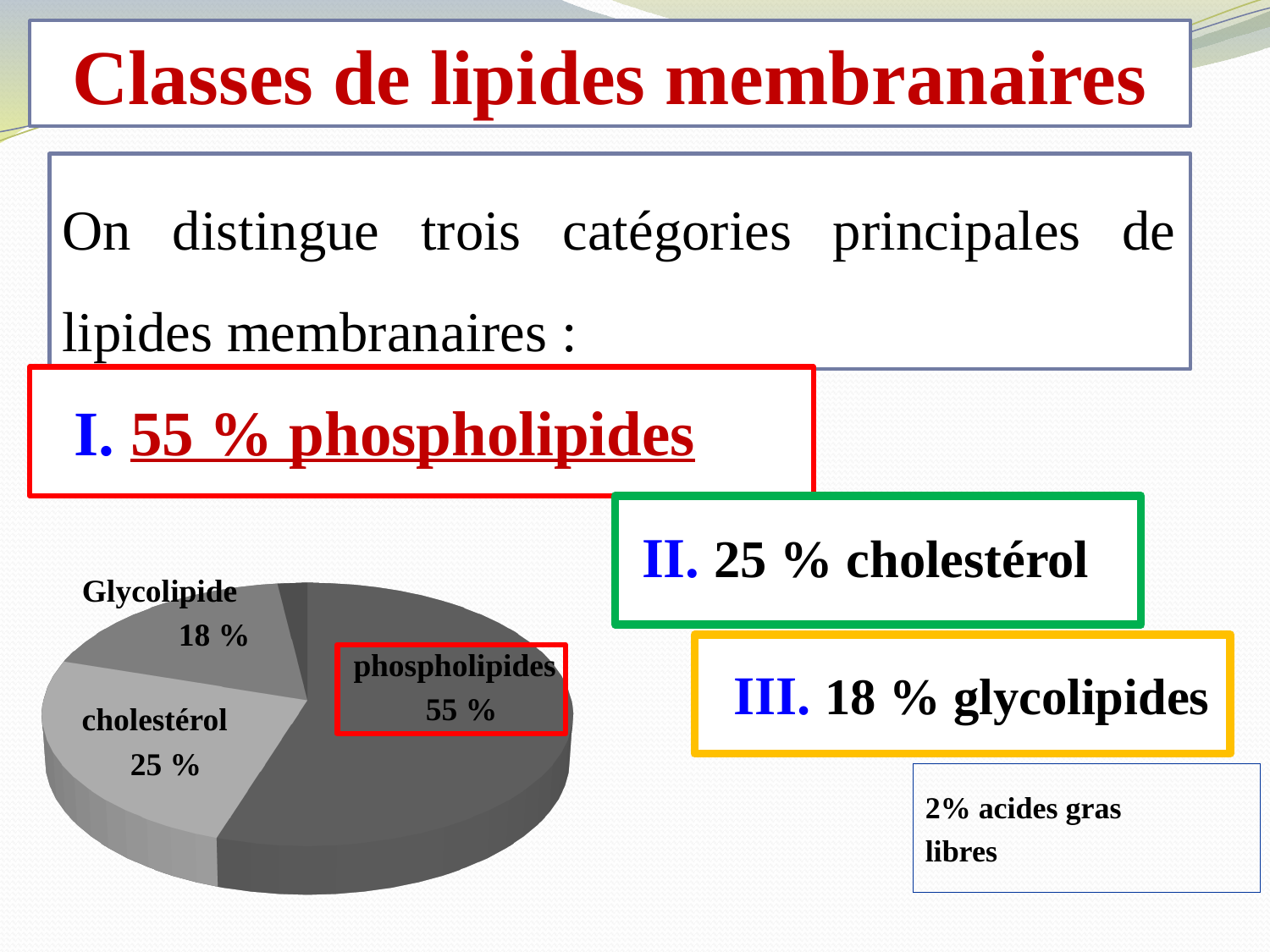
What percentage of the pie chart is Glycolipide? 18 % What kind of chart is shown on the slide? pie chart What percentage of the pie chart is cholestérol? 25 % What percentage of the pie chart is phospholipides? 55 % What is the difference between the cholestérol and Glycolipide shares in the pie chart? 7 % Among the three labelled slices of the pie chart, which is the smallest? Glycolipide What is the title of the slide containing the pie chart? Classes de lipides membranaires Is the phospholipides share in the pie chart greater or less than 50%? greater Which slice is larger in the pie chart, cholestérol or Glycolipide? cholestérol What is the difference between the phospholipides and cholestérol shares in the pie chart? 30 % Which slice of the pie chart is the largest? phospholipides How many slices in the pie chart have a label printed on them? 3